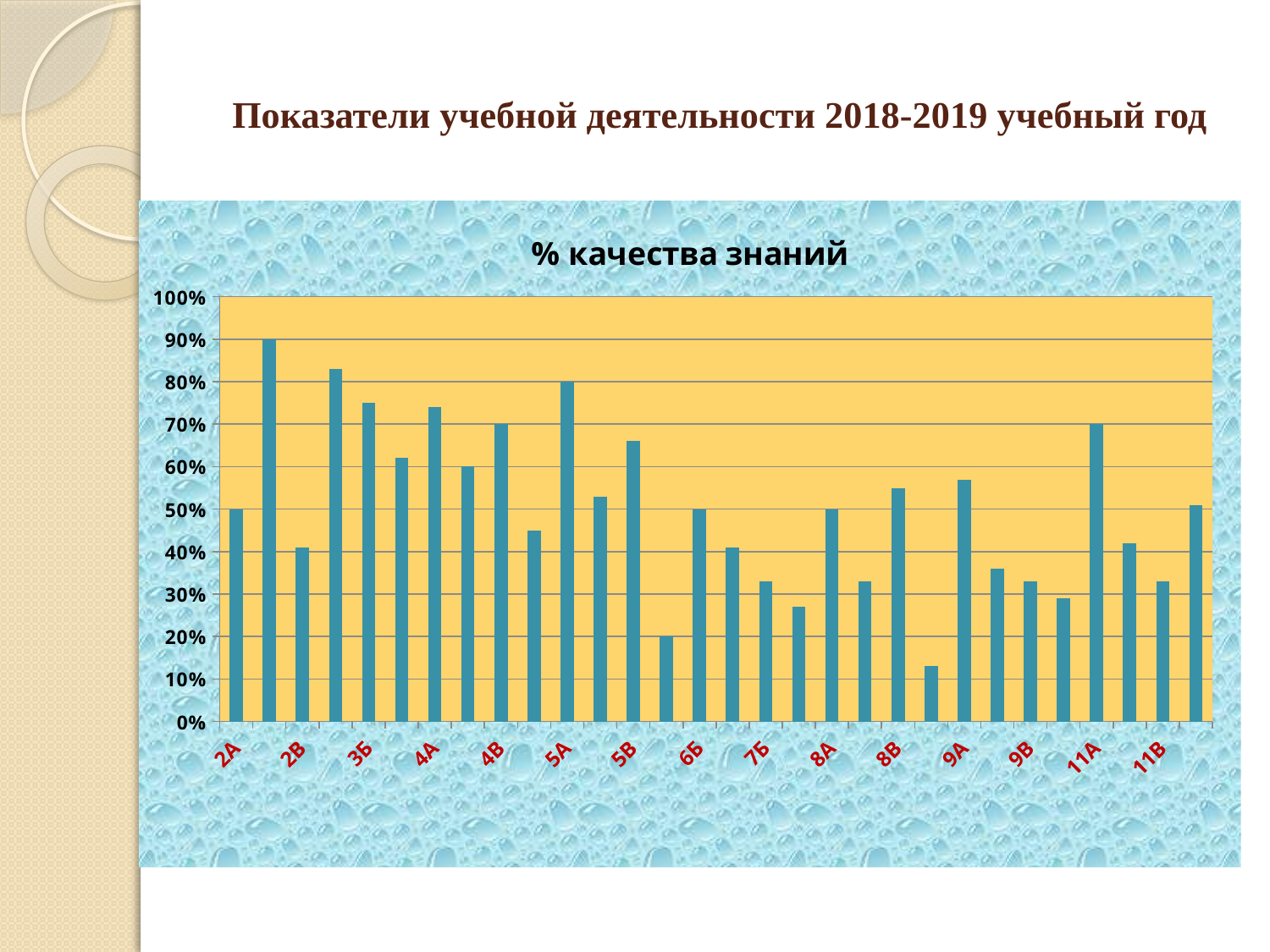
Is the value for 11В greater or less than 40%? less Is the value for 3Б greater or less than 70%? greater Is the value for 2В greater or less than 50%? less How many bars are plotted in the chart? 30 Which has the larger value, 5А or 7Б? 5А Which has the larger value, 3Б or 9В? 3Б What is the title of the chart? % качества знаний What kind of chart is shown on the slide? bar chart